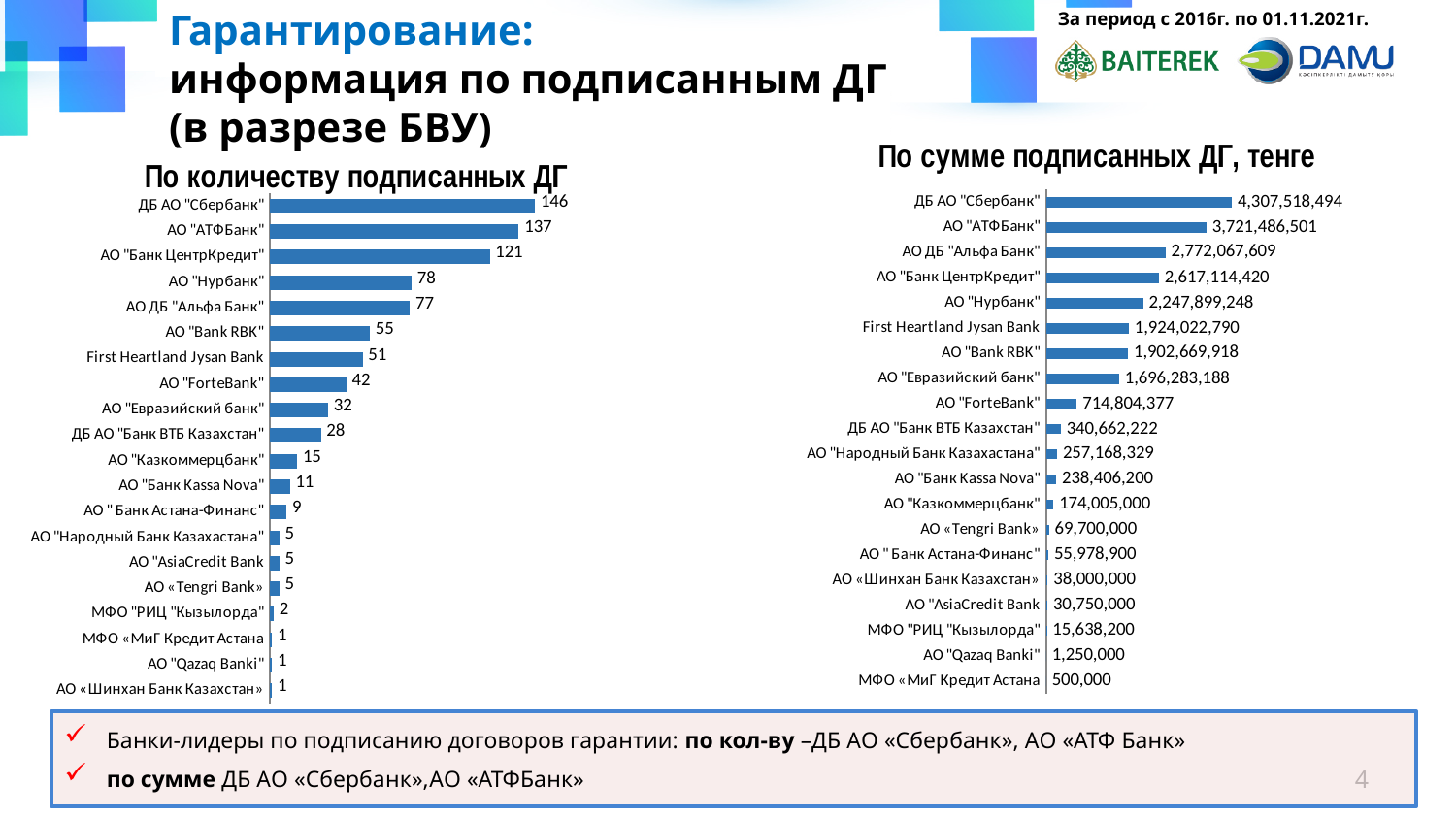
In the chart "По количеству подписанных ДГ", what is the difference between ДБ АО "Сбербанк" and АО "АТФБанк"? 9 In the chart "По сумме подписанных ДГ, тенге", what is the value for АО "АТФБанк"? 3,721,486,501 What type of chart is "По сумме подписанных ДГ, тенге"? Bar chart In the chart "По сумме подписанных ДГ, тенге", which bank has the lowest value? МФО «МиГ Кредит Астана» What is the title of the chart on the right side of the slide? По сумме подписанных ДГ, тенге In the chart "По сумме подписанных ДГ, тенге", what is the value for АО "ForteBank"? 714,804,377 In the chart "По количеству подписанных ДГ", what is the value for ДБ АО "Сбербанк"? 146 In the chart "По количеству подписанных ДГ", which bank has the highest value? ДБ АО "Сбербанк" How many banks are listed in the chart "По количеству подписанных ДГ"? 20 In the chart "По сумме подписанных ДГ, тенге", what is the difference between ДБ АО "Сбербанк" and АО "АТФБанк"? 586,031,993 In the chart "По количеству подписанных ДГ", what is the value for АО "Нурбанк"? 78 In the chart "По сумме подписанных ДГ, тенге", which is larger: АО ДБ "Альфа Банк" or АО "Банк ЦентрКредит"? АО ДБ "Альфа Банк"